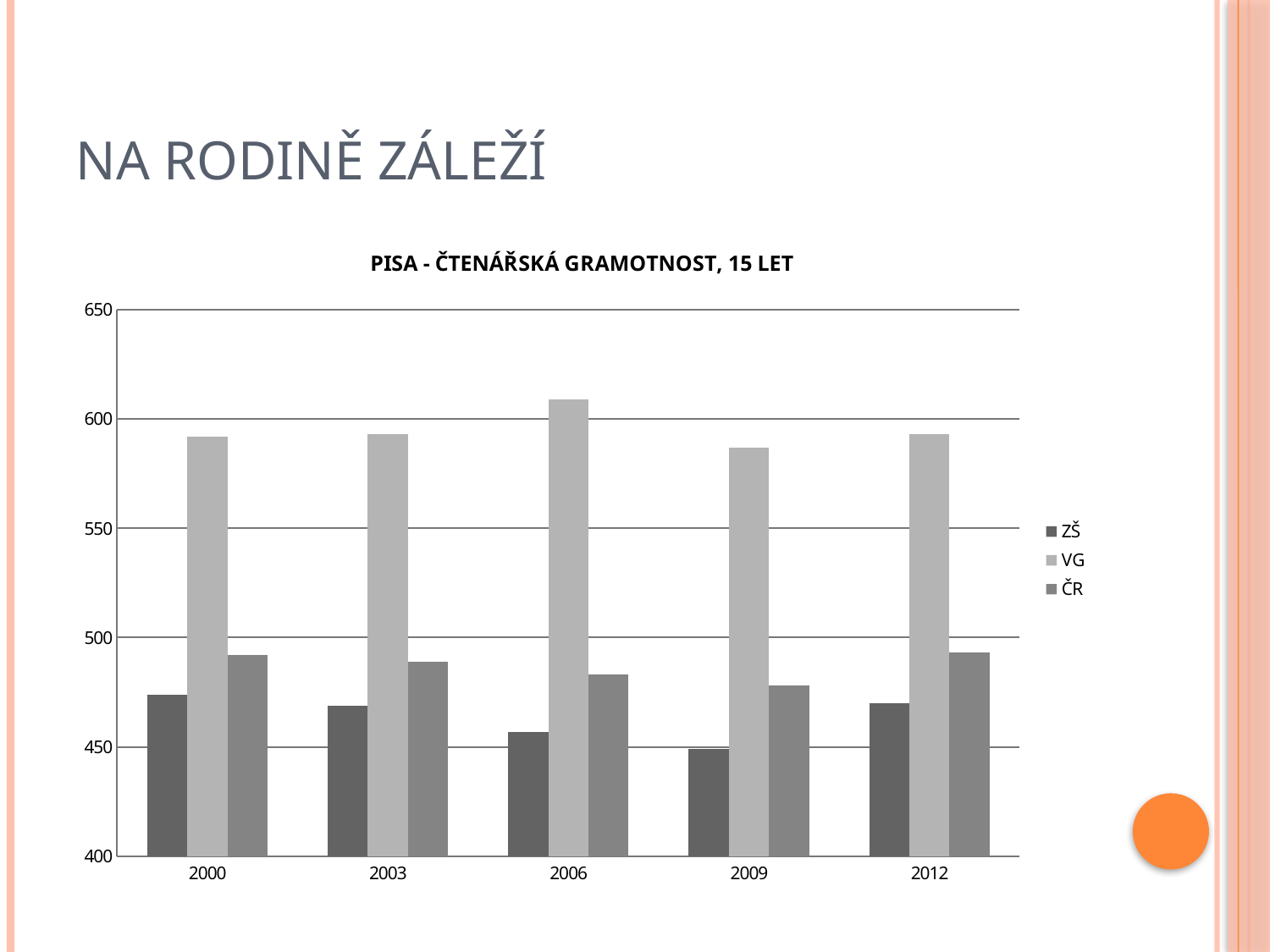
Is the VG value for 2009 greater or less than 600? less Which series are listed in the legend? ZŠ, VG, ČR How many years are shown on the x axis? 5 In which year is the VG value highest? 2006 What kind of chart is shown on the slide? bar chart How many series does the legend list? 3 Do the ZŠ values rise or fall from 2000 to 2009? fall Which is larger in 2012, the VG value or the ZŠ value? VG In which year is the ZŠ value lowest? 2009 Is the VG value for 2006 greater or less than 600? greater Is the ČR value for 2000 greater or less than 500? less What is the title of the chart? PISA - ČTENÁŘSKÁ GRAMOTNOST, 15 LET